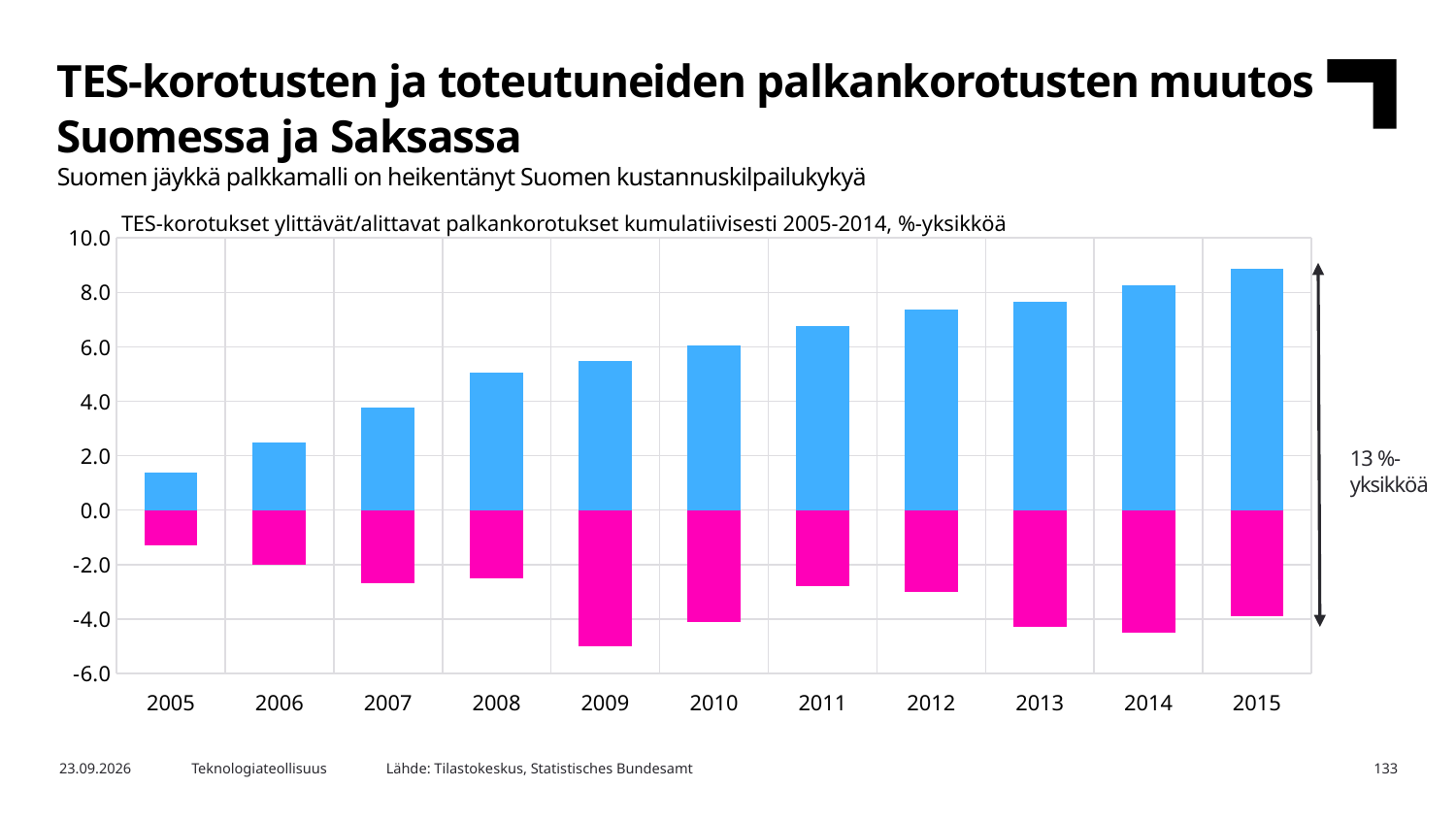
Which year has the shortest blue (positive) bar? 2005 Which year has the shortest magenta (negative) bar? 2005 Is the blue bar value for 2015 greater or less than 8.0? greater What kind of chart is shown on the slide? Bar chart Which year has the longest magenta (negative) bar? 2009 Which year has the tallest blue (positive) bar? 2015 Is the magenta bar value for 2009 greater or less than -4.0? less What value does the annotation with the arrow on the right side of the chart state? 13 %-yksikköä Do the blue (positive) bars rise or fall from 2005 to 2015? Rise Is the blue bar value for 2005 greater or less than 2.0? less Which year has a taller blue bar, 2008 or 2012? 2012 How many years are shown on the x axis of the chart? 11